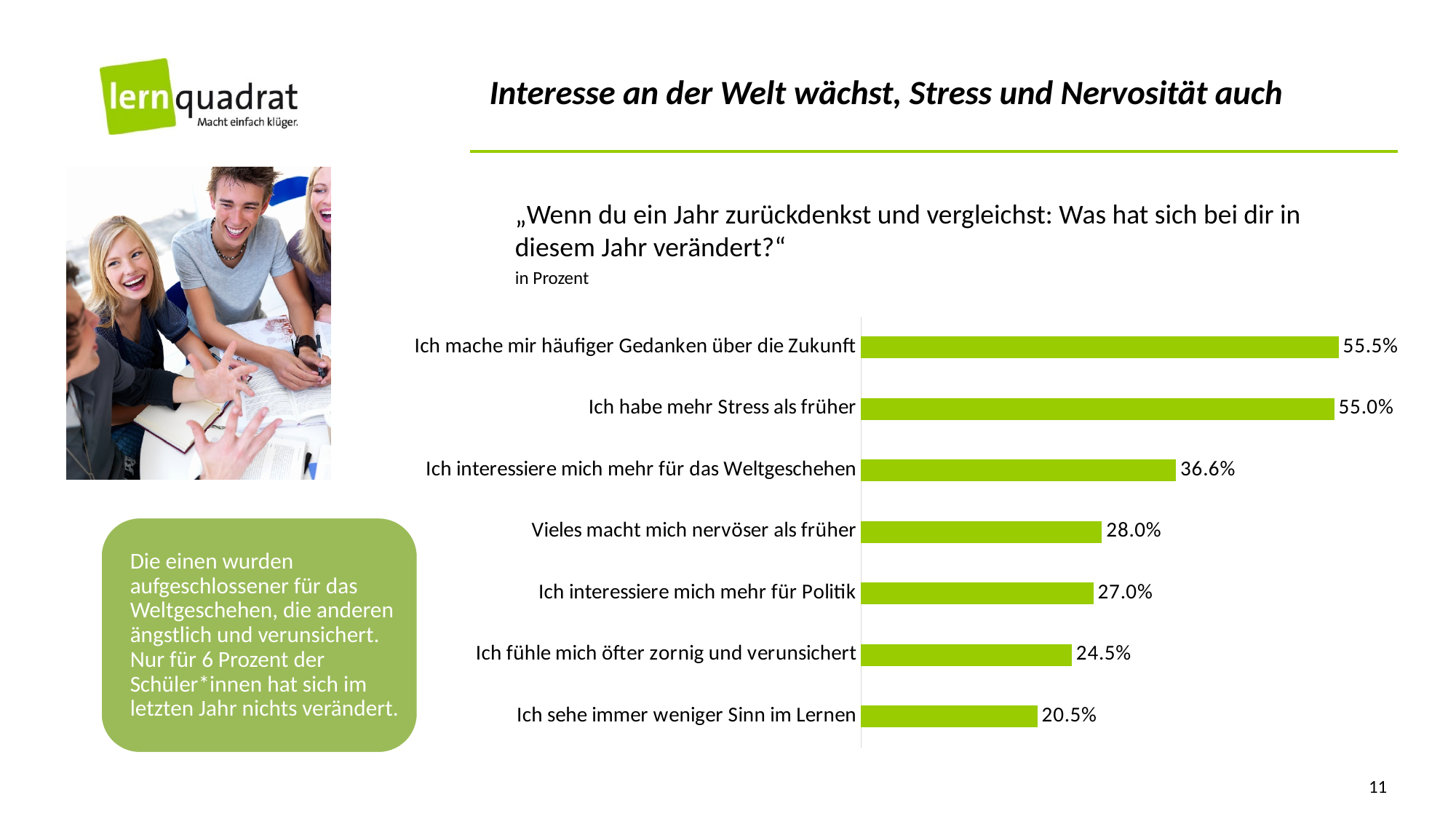
What is the value for "Ich sehe immer weniger Sinn im Lernen"? 20.5% How many categories are shown in the chart? 7 What is the value for "Ich interessiere mich mehr für das Weltgeschehen"? 36.6% What is the difference between "Vieles macht mich nervöser als früher" and "Ich sehe immer weniger Sinn im Lernen"? 7.5% What percentage of respondents said "Ich habe mehr Stress als früher"? 55.0% Which category has the lowest value? Ich sehe immer weniger Sinn im Lernen Which category has the highest value? Ich mache mir häufiger Gedanken über die Zukunft What is the difference between "Ich interessiere mich mehr für das Weltgeschehen" and "Ich interessiere mich mehr für Politik"? 9.6% Which is larger: "Vieles macht mich nervöser als früher" or "Ich fühle mich öfter zornig und verunsichert"? Vieles macht mich nervöser als früher What kind of chart is shown on the slide? Bar chart What is the value for "Ich fühle mich öfter zornig und verunsichert"? 24.5% What unit is stated below the chart's question heading? in Prozent